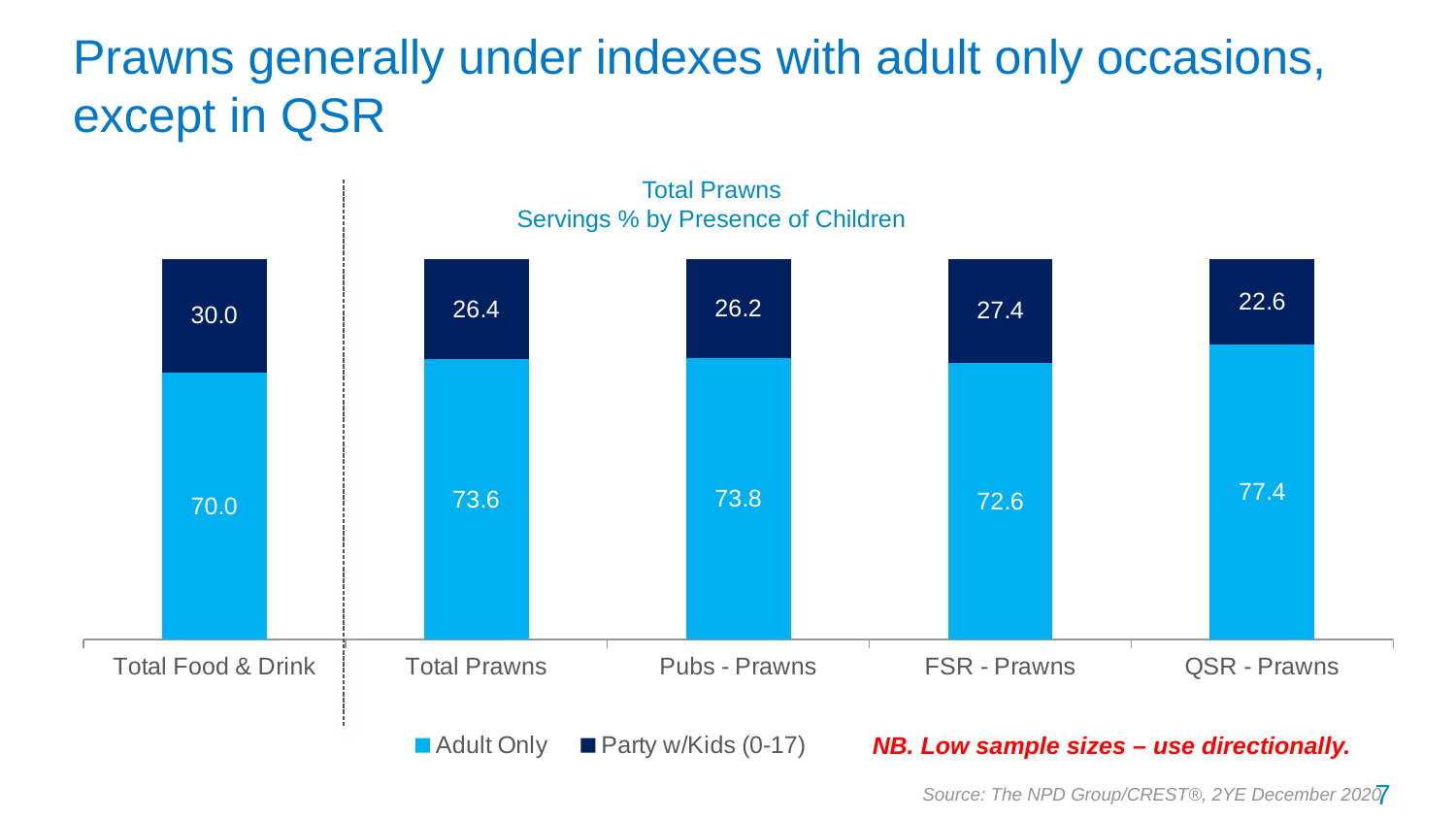
What is the Adult Only value for Pubs - Prawns? 73.8 What kind of chart is shown on the slide? Stacked bar chart Which is larger, the Party w/Kids (0-17) value for Total Food & Drink or for Total Prawns? Total Food & Drink What is the Adult Only value for QSR - Prawns? 77.4 How many series does the legend list? 2 What is the Party w/Kids (0-17) value for Total Food & Drink? 30.0 Which category has the highest Adult Only value? QSR - Prawns How many categories are shown on the x axis? 5 What is the Party w/Kids (0-17) value for FSR - Prawns? 27.4 Which category has the lowest Party w/Kids (0-17) value? QSR - Prawns What is the difference between the Adult Only values for QSR - Prawns and Total Food & Drink? 7.4 What is the title of the chart? Total Prawns Servings % by Presence of Children